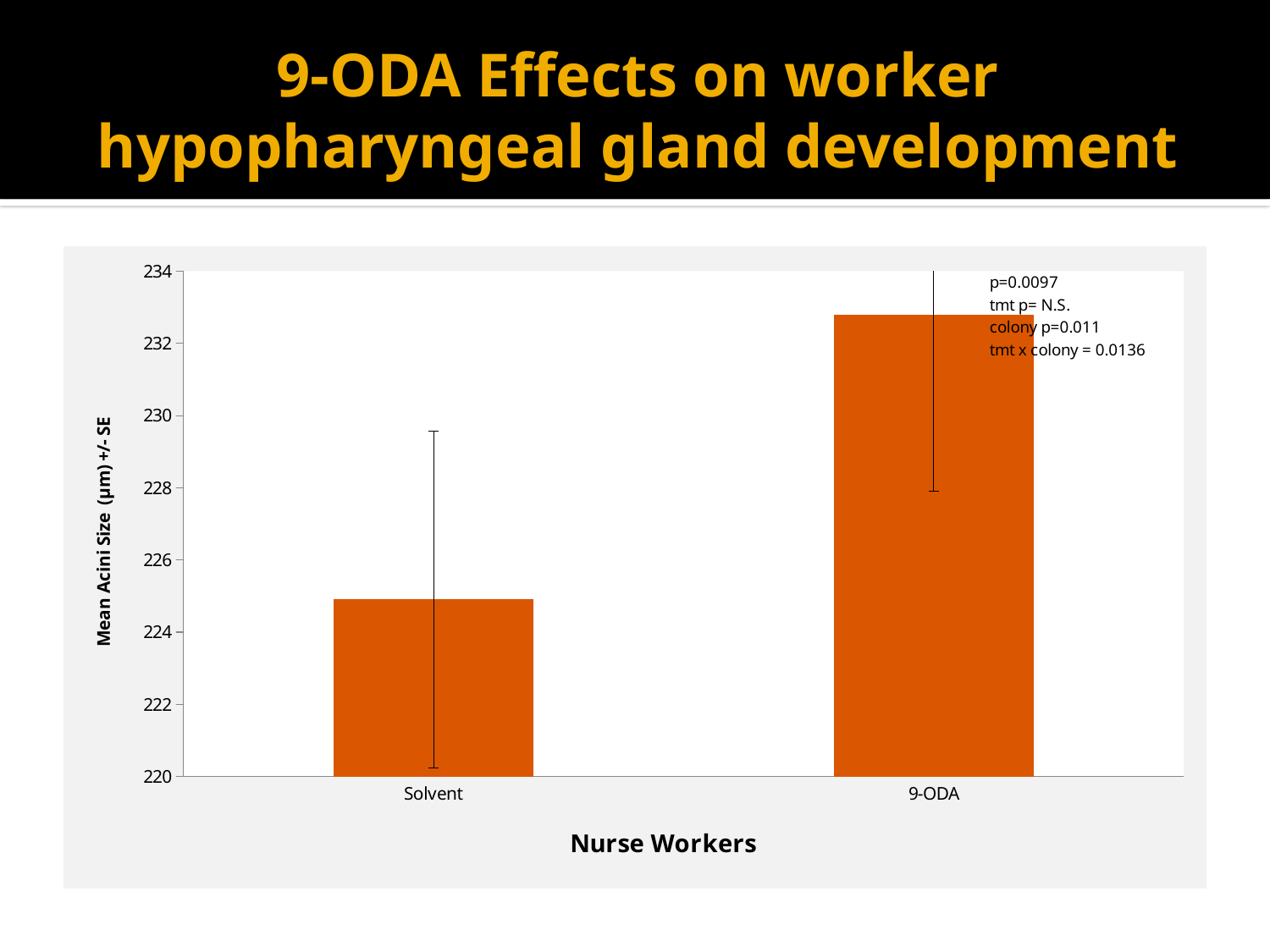
Which category has the lowest bar? Solvent What is the tmt x colony value shown in the annotation on the chart? 0.0136 What is the label of the y axis? Mean Acini Size (µm) +/- SE Is the value for Solvent greater or less than 224? greater How many categories are plotted on the x axis? 2 Is the value for 9-ODA greater or less than 232? greater What kind of chart is shown on the slide? bar chart What is the p-value for colony shown in the annotation on the chart? 0.011 Which category has the highest bar? 9-ODA Is the value for Solvent greater or less than 226? less What is the label of the x axis? Nurse Workers Which category has the higher mean acini size, Solvent or 9-ODA? 9-ODA